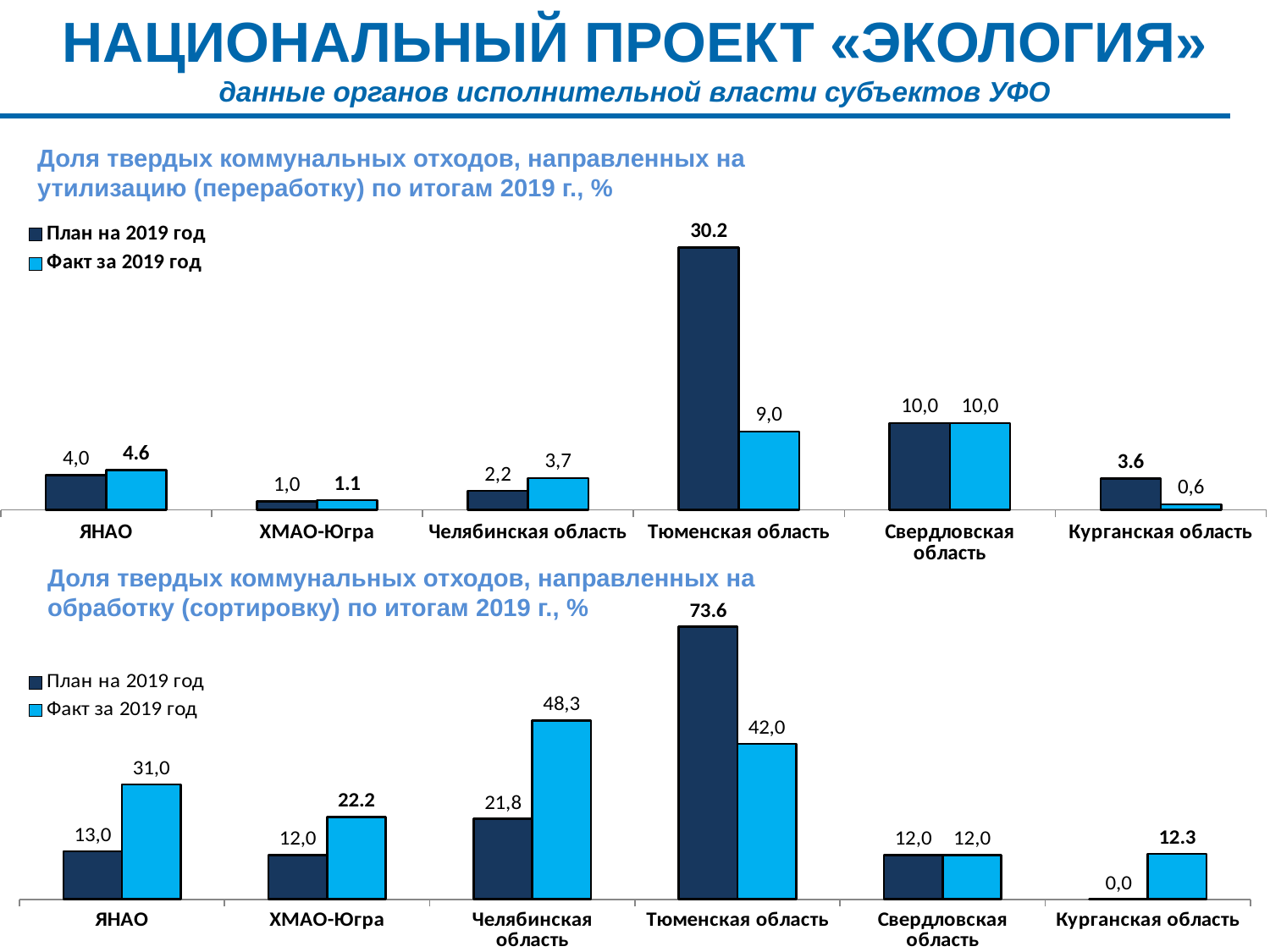
In the bottom chart (обработку/сортировку), what is the 'План на 2019 год' value for Курганская область? 0,0 In the top chart (утилизацию/переработку), what is the 'Факт за 2019 год' value for Курганская область? 0,6 In the bottom chart (обработку/сортировку), is the 'Факт за 2019 год' value for ЯНАО larger or smaller than its 'План на 2019 год' value? larger In the top chart (утилизацию/переработку), which region has the lowest 'Факт за 2019 год' value? Курганская область In the bottom chart (обработку/сортировку), what is the 'Факт за 2019 год' value for Челябинская область? 48,3 In the top chart (утилизацию/переработку), how many regions are shown on the x axis? 6 In the top chart (утилизацию/переработку), which region has the highest 'План на 2019 год' value? Тюменская область In the top chart (утилизацию/переработку), what is the difference between the 'План на 2019 год' and 'Факт за 2019 год' values for Тюменская область? 21.2 What type of chart is the bottom chart (обработку/сортировку)? bar chart In the bottom chart (обработку/сортировку), how many series does the legend list? 2 In the bottom chart (обработку/сортировку), which region has the highest 'Факт за 2019 год' value? Челябинская область In the top chart (утилизацию/переработку), what is the 'План на 2019 год' value for Тюменская область? 30.2